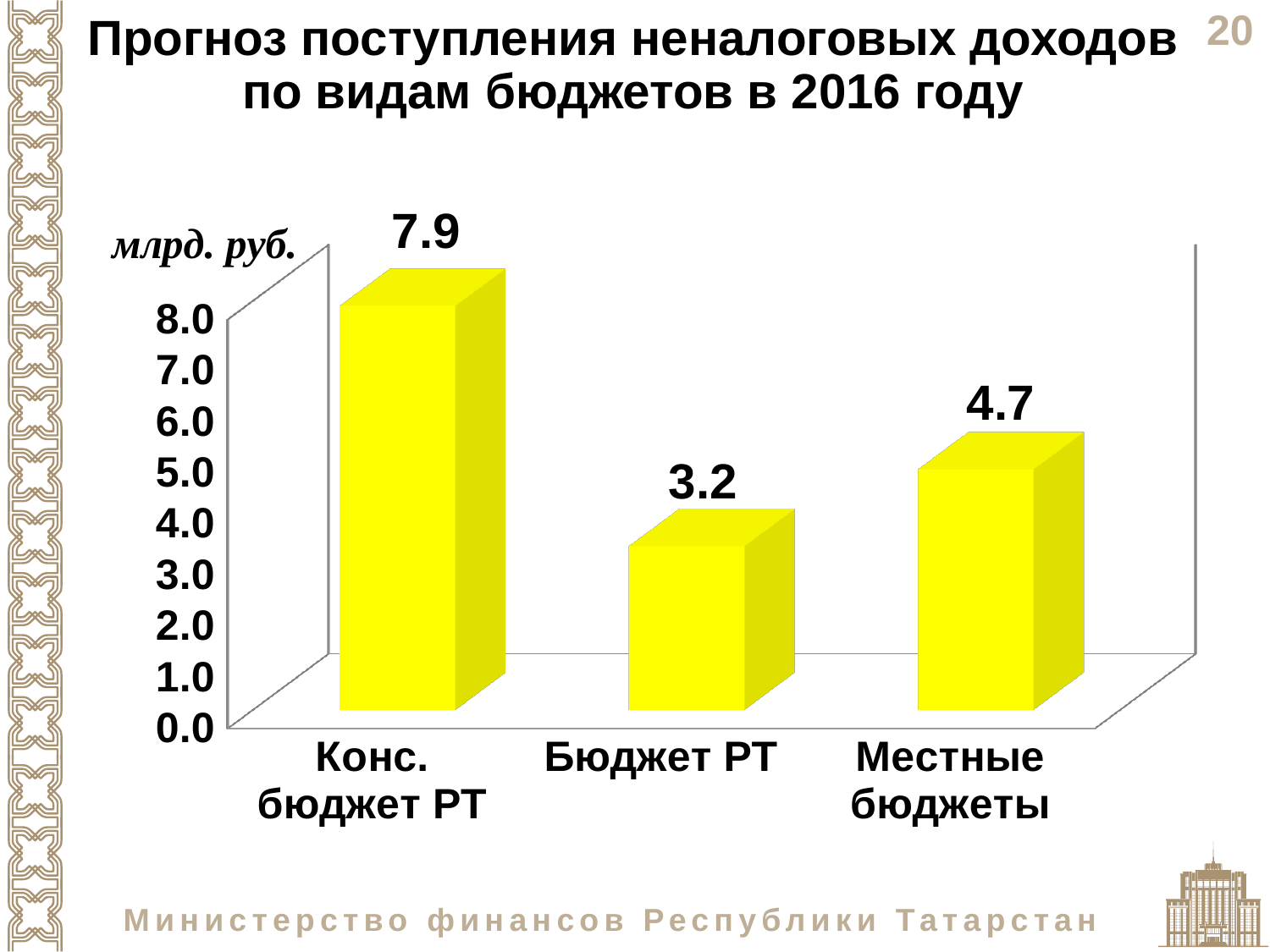
Which category has the lowest value? Бюджет РТ Which category has the highest value? Конс. бюджет РТ How many categories are shown on the chart? 3 What is the difference between the values for Местные бюджеты and Бюджет РТ? 1.5 What is the value for Конс. бюджет РТ? 7.9 What unit is shown on the chart's axis label? млрд. руб. Is the value for Местные бюджеты greater or less than 4.0? greater What is the difference between the values for Конс. бюджет РТ and Бюджет РТ? 4.7 What is the value for Местные бюджеты? 4.7 Which is larger, the value for Местные бюджеты or the value for Бюджет РТ? Местные бюджеты What is the value for Бюджет РТ? 3.2 What kind of chart is shown on the slide? bar chart